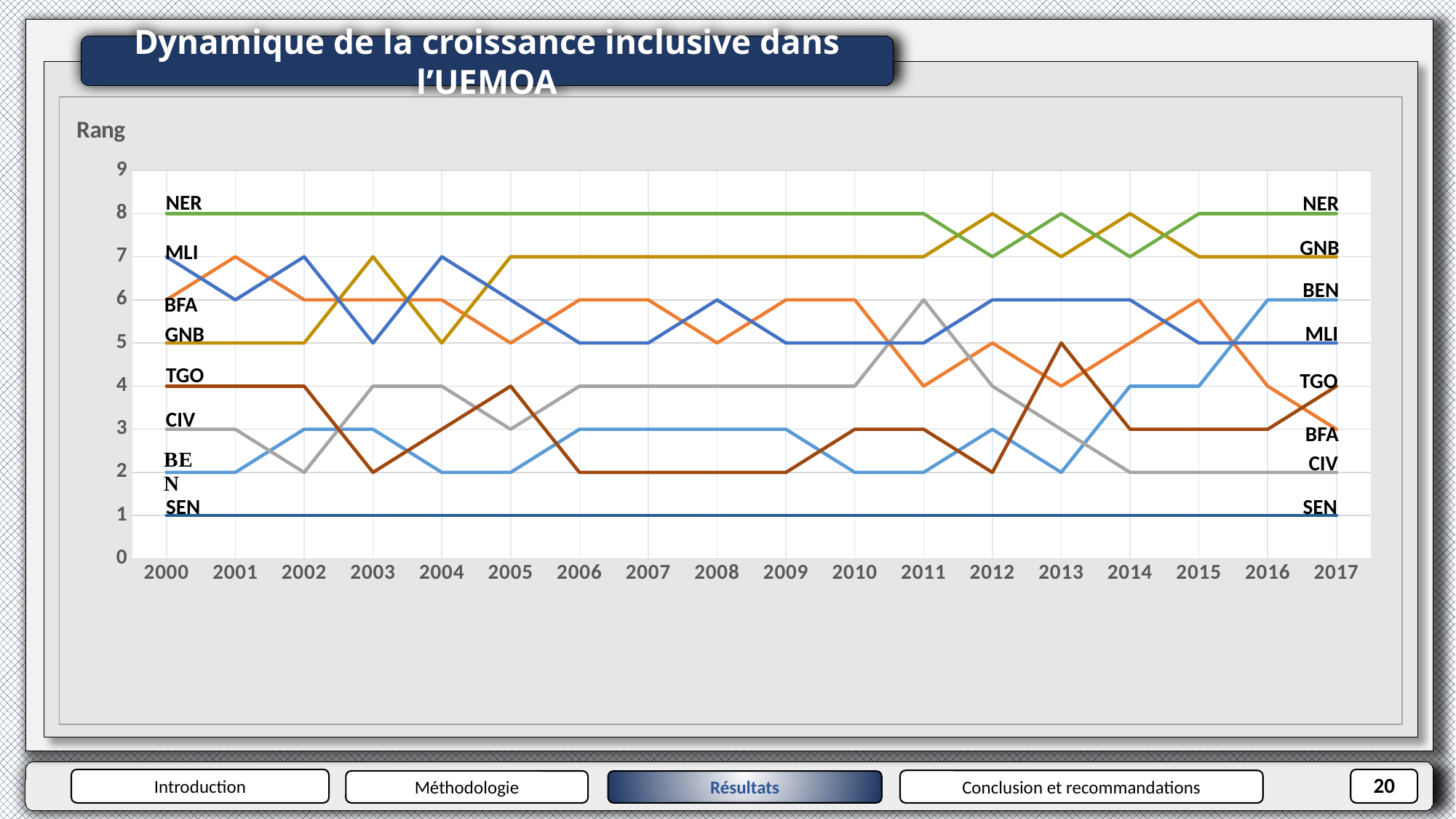
What is the rank of NER in 2000? 8 In 2017, which has the higher rank value, BEN or MLI? BEN What is the rank of BFA in 2000? 6 What is the rank of BEN in 2017? 6 Which country has the highest rank value in 2017? NER What is the label of the vertical axis? Rang What is the difference between the rank of NER and the rank of SEN in 2017? 7 What is the rank of GNB in 2017? 7 How many years are shown on the x axis? 18 What is the rank of SEN in 2017? 1 Which country has the lowest rank value in 2000? SEN What kind of chart is shown on the slide? line chart